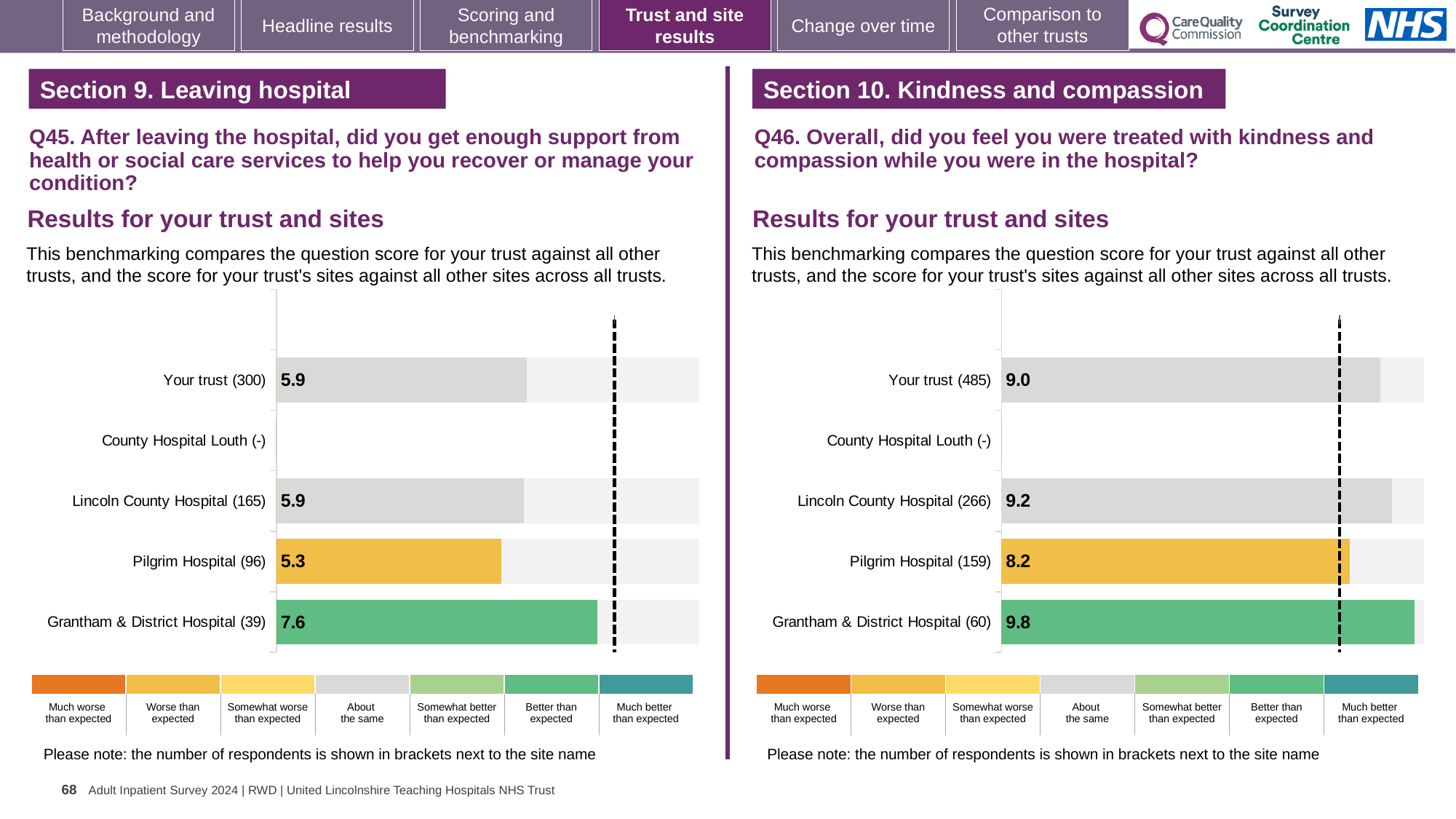
In the Q46 chart on the right, which site has the lowest score? Pilgrim Hospital (159) In the Q45 chart on the left, what is the score for Your trust (300)? 5.9 In the Q46 chart on the right, what is the score for Grantham & District Hospital (60)? 9.8 In the Q46 chart on the right, which is larger: the score for Your trust or the score for Lincoln County Hospital? Lincoln County Hospital In the Q46 chart on the right, what is the difference between the scores for Your trust and Pilgrim Hospital? 0.8 In the Q45 chart on the left, what is the score for Pilgrim Hospital (96)? 5.3 What type of chart is used for the Q45 results on the left? Bar chart In the Q45 chart on the left, which site has the highest score? Grantham & District Hospital (39) In the Q45 chart on the left, which site has the lowest score? Pilgrim Hospital (96) How many benchmark categories does the colour legend below the Q46 chart list? 7 In the Q46 chart on the right, what is the score for Lincoln County Hospital (266)? 9.2 In the Q45 chart on the left, what is the difference between the scores for Grantham & District Hospital and Pilgrim Hospital? 2.3